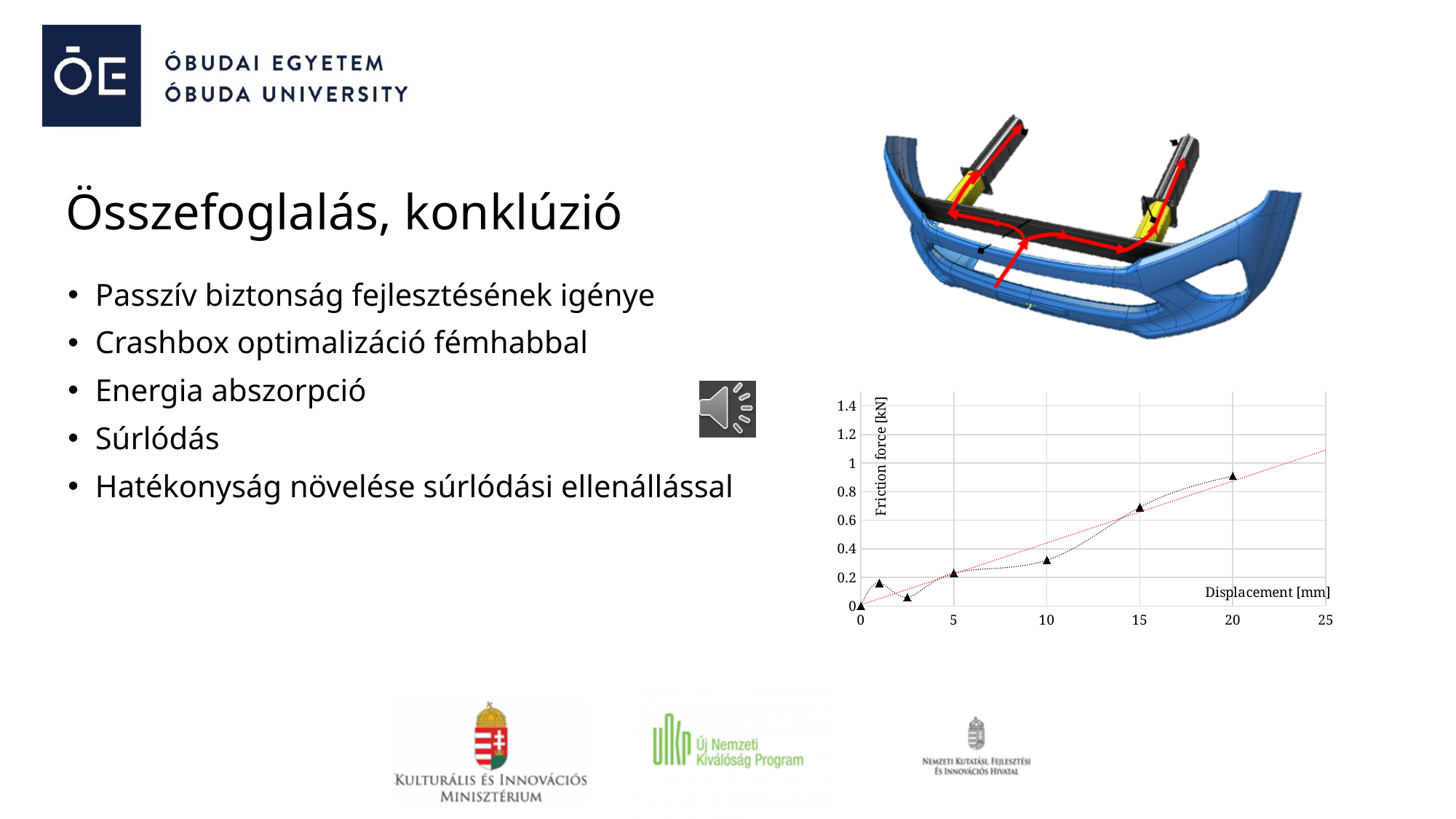
Which displacement has the larger friction force, 10 mm or 15 mm? 15 mm Is the friction force at a displacement of 15 mm greater or less than 0.6 kN? greater At which displacement is the friction force highest? 20 At which displacement is the friction force lowest? 0 What is the label of the vertical axis of the chart? Friction force [kN] Is the friction force at a displacement of 20 mm greater or less than 0.8 kN? greater What is the label of the horizontal axis of the chart? Displacement [mm] What is the friction force at a displacement of 0 mm? 0 What kind of chart is shown on the slide? line chart How many data points are plotted on the chart? 7 Does the friction force generally rise or fall as displacement increases? rise Is the friction force at a displacement of 10 mm greater or less than 0.4 kN? less